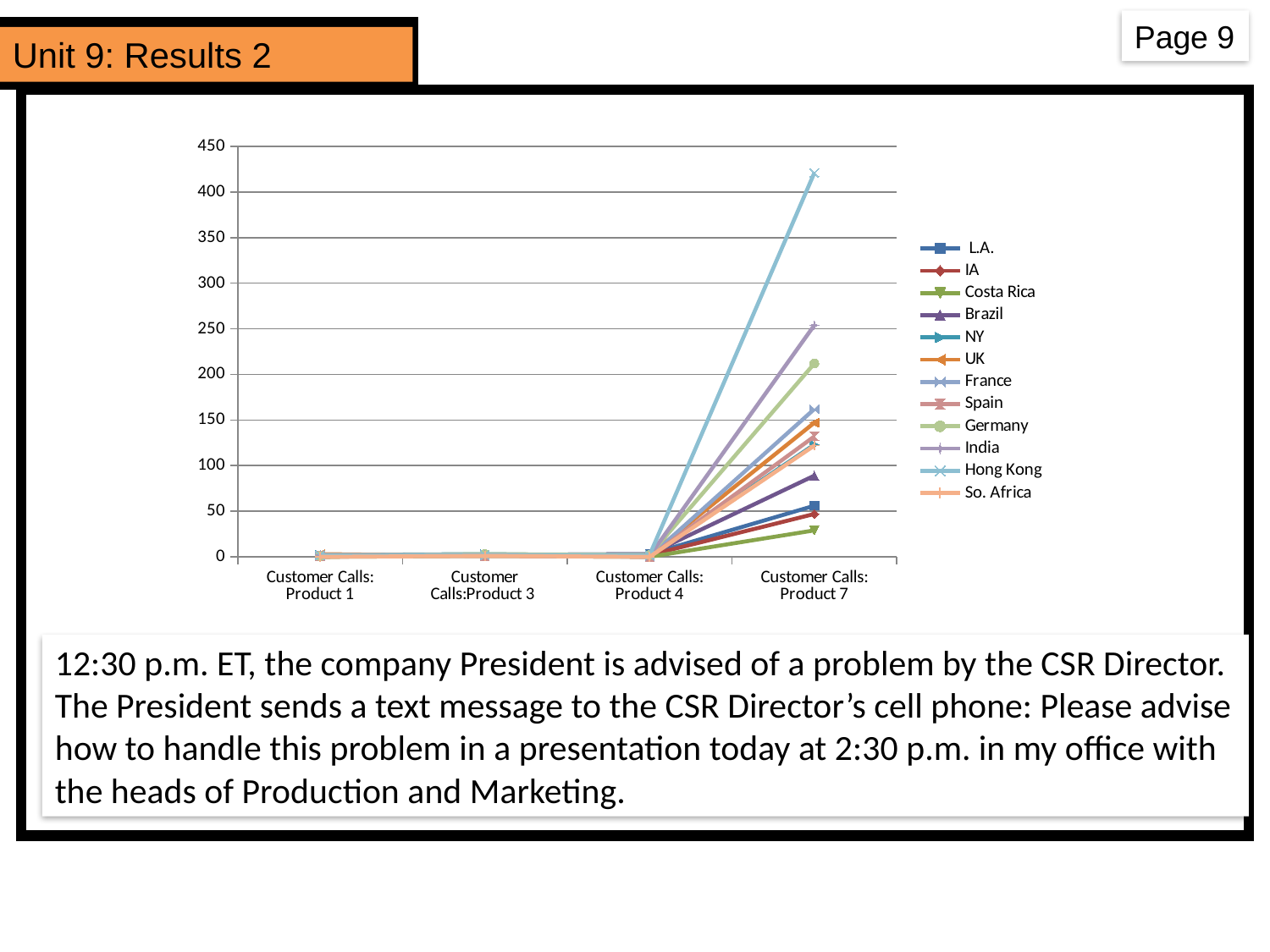
Which series is listed last in the chart's legend? So. Africa Do the values for Hong Kong rise or fall from Customer Calls: Product 4 to Customer Calls: Product 7? rise How many series does the chart's legend list? 12 Is the value for Costa Rica at Customer Calls: Product 7 greater or less than 50? less How many categories are shown along the x axis of the chart? 4 Which series has the lowest value at Customer Calls: Product 7? Costa Rica Is the value for Brazil at Customer Calls: Product 7 greater or less than 100? less Is the value for Germany at Customer Calls: Product 7 greater or less than 200? greater At Customer Calls: Product 7, which is larger, the value for Hong Kong or the value for India? Hong Kong Which series has the highest value at Customer Calls: Product 7? Hong Kong What kind of chart is shown on the slide? line chart